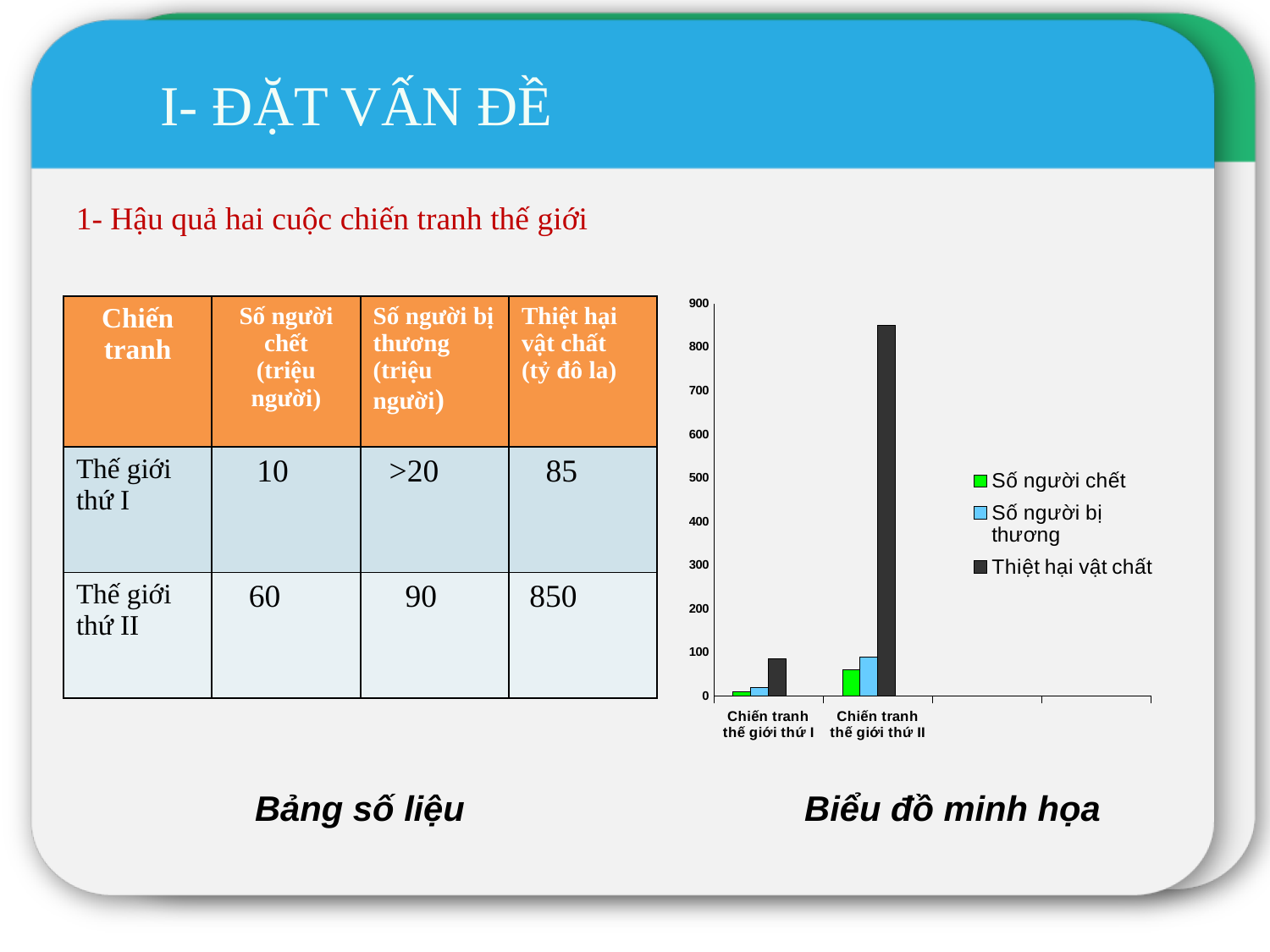
How many series does the chart's legend list? 3 Do the values for each series rise or fall from Chiến tranh thế giới thứ I to Chiến tranh thế giới thứ II? rise What kind of chart is shown on the slide? bar chart Which category has the larger Thiệt hại vật chất bar, Chiến tranh thế giới thứ I or Chiến tranh thế giới thứ II? Chiến tranh thế giới thứ II For Chiến tranh thế giới thứ II, which bar is taller: Số người chết or Số người bị thương? Số người bị thương Is the Thiệt hại vật chất value for Chiến tranh thế giới thứ II greater or less than 800? greater Is the Số người chết value for Chiến tranh thế giới thứ II greater or less than 100? less Which series and category has the tallest bar in the chart? Thiệt hại vật chất, Chiến tranh thế giới thứ II Which series is shown in green in the chart's legend? Số người chết Which series and category has the shortest bar in the chart? Số người chết, Chiến tranh thế giới thứ I How many categories are shown on the x axis of the chart? 2 Is the Thiệt hại vật chất value for Chiến tranh thế giới thứ I greater or less than 100? less